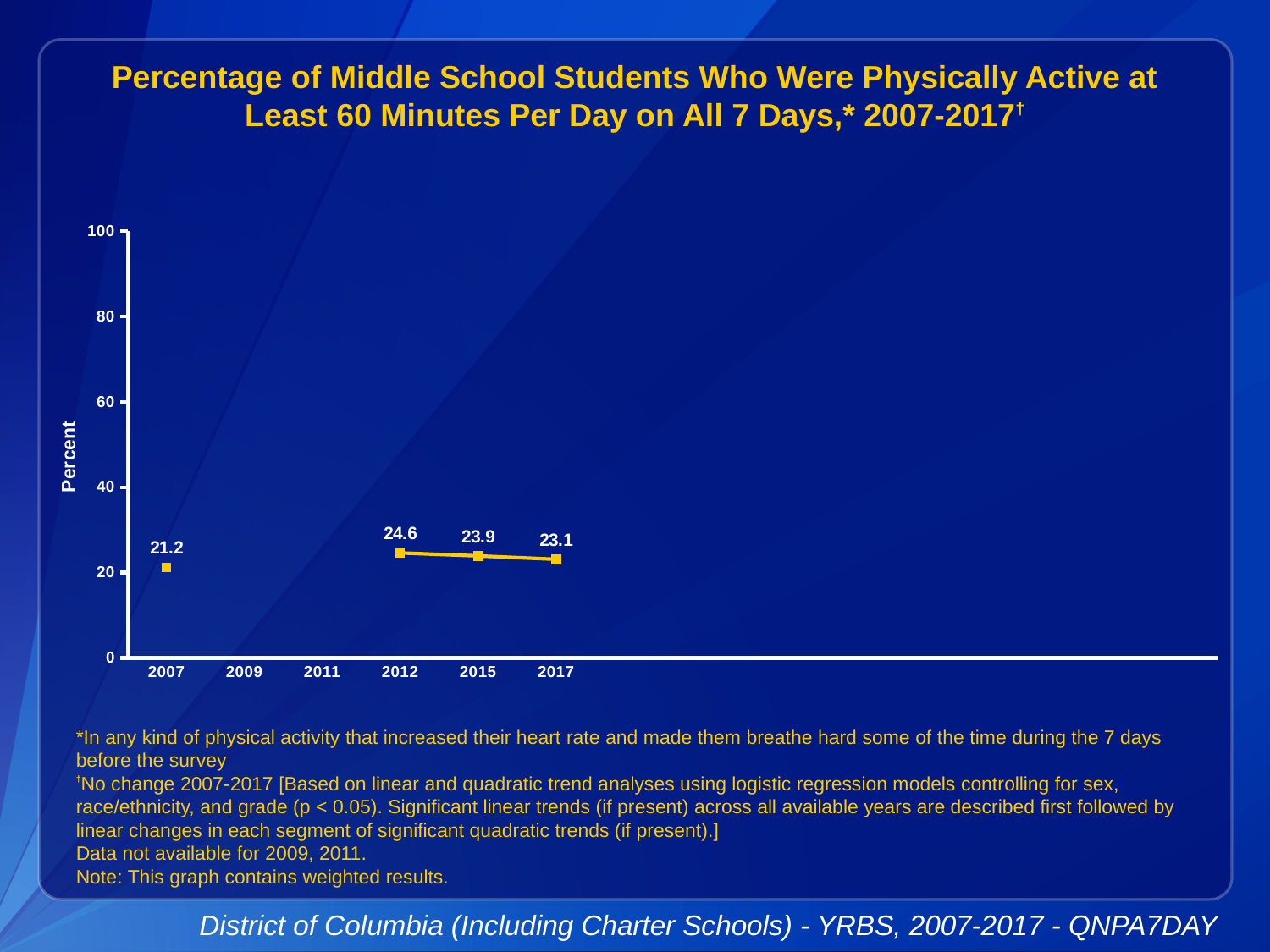
Which year has a larger value, 2007 or 2015? 2015 What percentage of middle school students were physically active at least 60 minutes per day on all 7 days in 2007? 21.2 Which year has the lowest value on the chart? 2007 What is the difference between the 2012 value and the 2017 value? 1.5 Which year has the highest value on the chart? 2012 Is the value for 2012 greater or less than 40? less How many years have data points plotted on the chart? 4 What is the value plotted for 2012? 24.6 What kind of chart is shown on the slide? line chart What is the value plotted for 2015? 23.9 What is the value plotted for 2017? 23.1 Do the values rise or fall from 2012 to 2017? fall